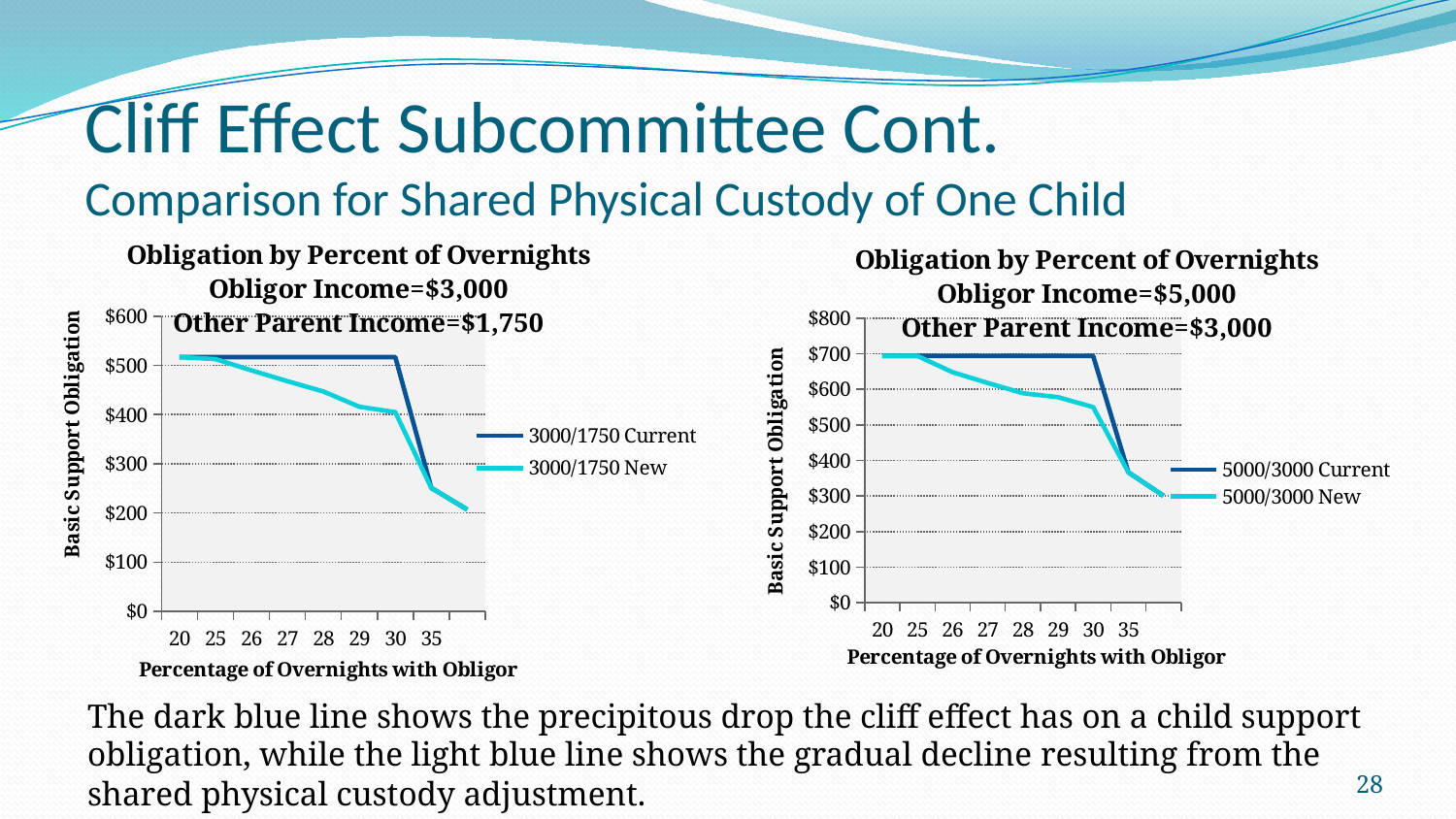
In the left chart (Obligor Income=$3,000), is the value of the 3000/1750 Current line at 20 overnights greater or less than $600? less In the left chart (Obligor Income=$3,000), what are the two legend entries? 3000/1750 Current and 3000/1750 New In the right chart (Obligor Income=$5,000), is the value of the 5000/3000 Current line at 20 overnights greater or less than $600? greater In the left chart (Obligor Income=$3,000), is the value of the 3000/1750 New line at 35 overnights greater or less than $300? less In the right chart (Obligor Income=$5,000), do the values of the 5000/3000 New line rise or fall along the x axis? fall What kind of chart is the left chart, 'Obligation by Percent of Overnights Obligor Income=$3,000'? line chart In the right chart (Obligor Income=$5,000), what is the title of the y axis? Basic Support Obligation In the left chart (Obligor Income=$3,000), at 28 overnights, which line is higher: 3000/1750 Current or 3000/1750 New? 3000/1750 Current In the right chart (Obligor Income=$5,000), at 29 overnights, which line is higher: 5000/3000 Current or 5000/3000 New? 5000/3000 Current In the left chart (Obligor Income=$3,000), do the values of the 3000/1750 New line rise or fall as the percentage of overnights increases? fall How many series does the legend of the right chart (Obligor Income=$5,000) list? 2